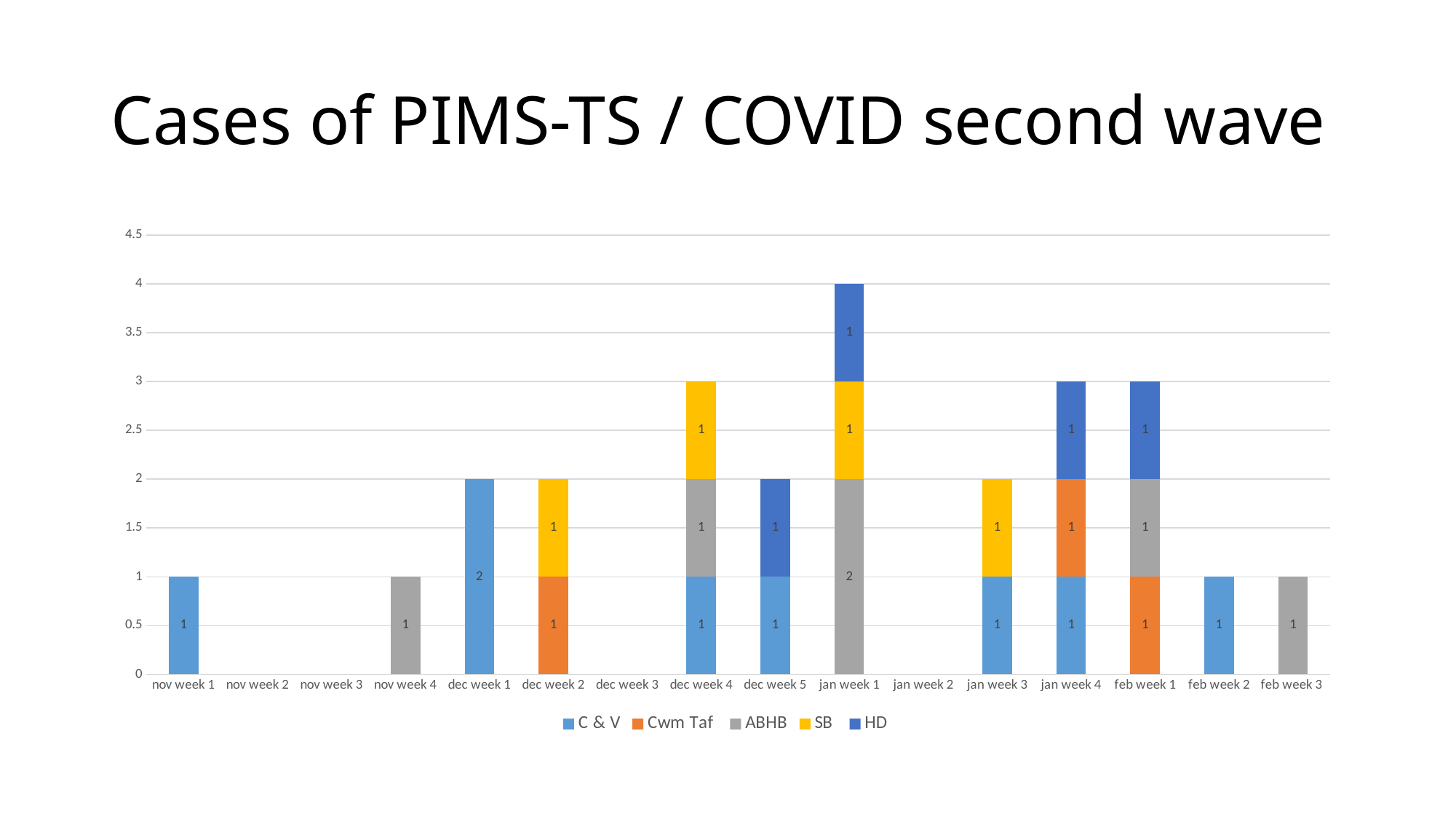
What is the value for ABHB in jan week 1? 2 How many week categories are shown on the x axis? 16 What is the title of the chart? Cases of PIMS-TS / COVID second wave What is the total number of cases in dec week 4? 3 What is the total number of cases in jan week 1? 4 What is the value for C & V in dec week 1? 2 How many series does the legend list? 5 Which is larger, the total for dec week 2 or the total for jan week 4? jan week 4 Which week has the highest total number of cases? jan week 1 What kind of chart is shown on the slide? Stacked bar chart What is the difference between the total cases in jan week 1 and feb week 1? 1 Which series is shown in yellow in the legend? SB